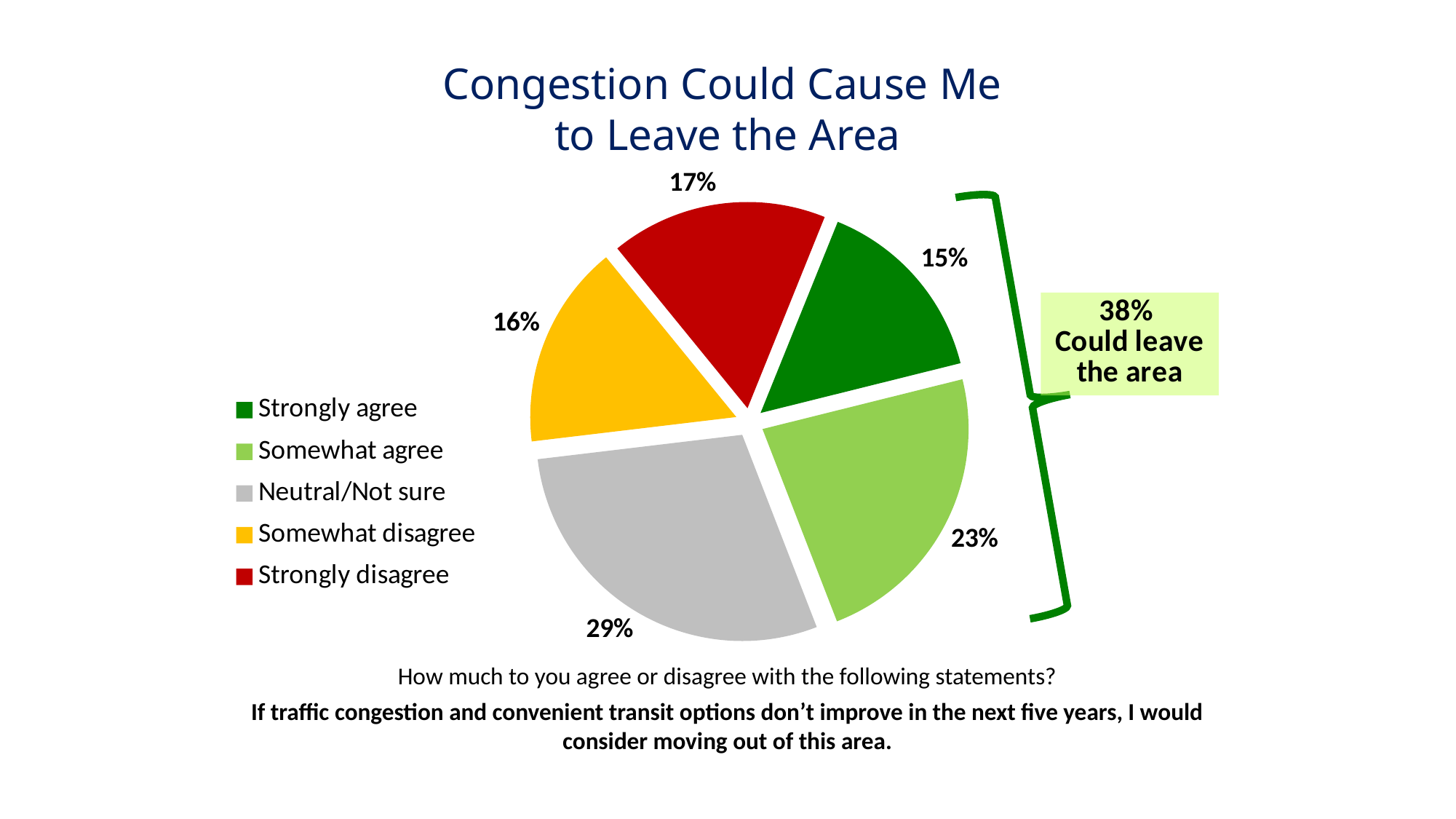
What percentage of respondents answered Somewhat agree? 23% Which response category has the largest share of the pie? Neutral/Not sure What is the title of the chart? Congestion Could Cause Me to Leave the Area Which response category has the smallest share of the pie? Strongly agree What is the difference in percentage points between Neutral/Not sure and Somewhat agree? 6 What percentage of respondents answered Strongly disagree? 17% Which is larger, the share for Somewhat agree or the share for Strongly disagree? Somewhat agree What kind of chart is shown on the slide? pie chart What percentage of respondents answered Somewhat disagree? 16% How many categories does the legend list? 5 What percentage of respondents answered Neutral/Not sure? 29% What percentage of respondents answered Strongly agree? 15%